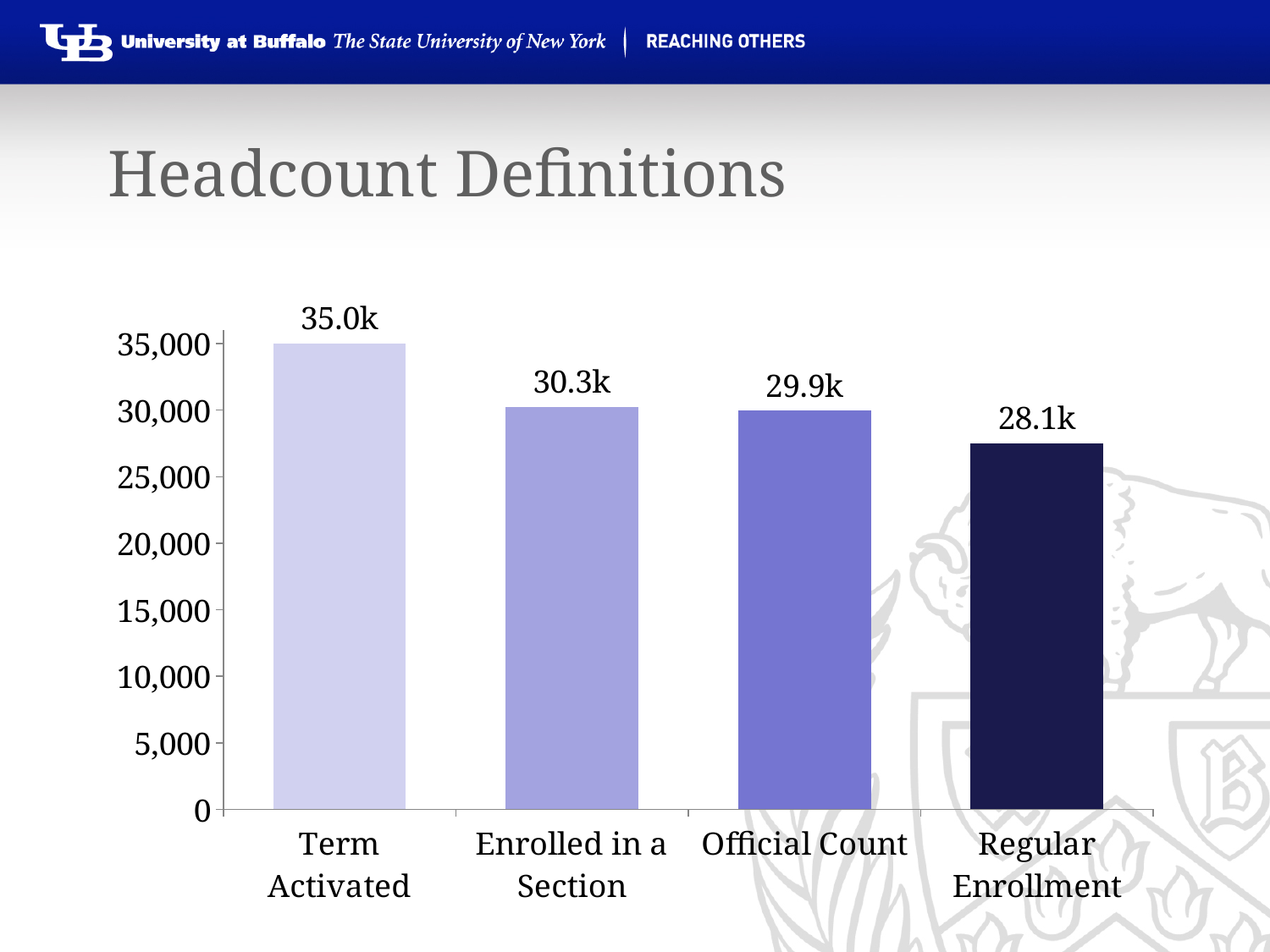
Which category has the lowest value? Regular Enrollment What is the value for Term Activated? 35.0k How many categories are shown on the x axis? 4 What is the value for Enrolled in a Section? 30.3k Which is larger, the value for Enrolled in a Section or the value for Regular Enrollment? Enrolled in a Section Do the values rise or fall from left to right along the x axis? fall Is the value for Regular Enrollment greater or less than 30,000? less What is the value for Official Count? 29.9k What kind of chart is shown on the slide? bar chart Which category has the highest value? Term Activated What is the difference between the values for Term Activated and Regular Enrollment? 6.9k What is the value for Regular Enrollment? 28.1k